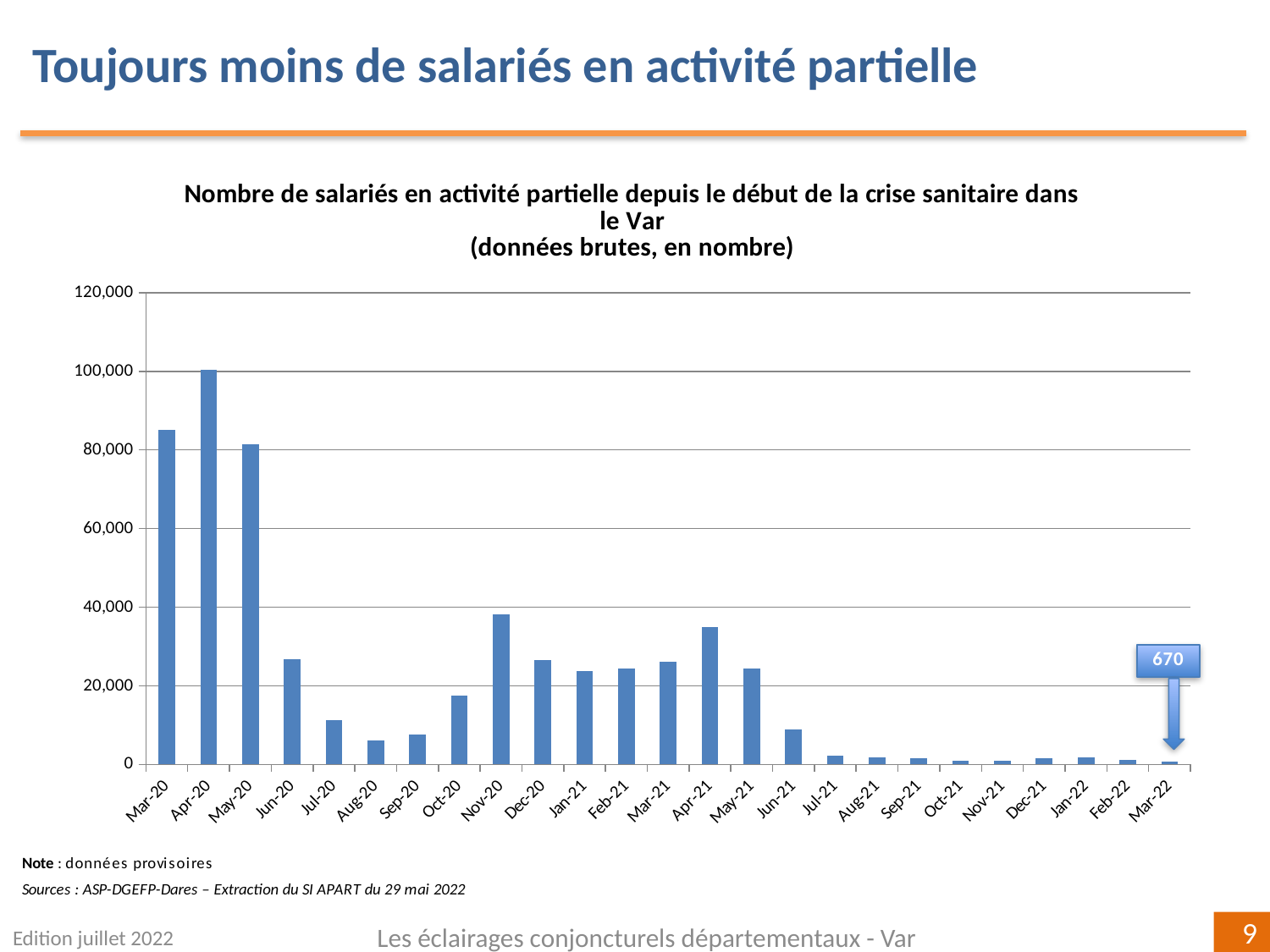
Is the value for Mar-20 greater or less than 80,000? greater Which is larger, the value for Apr-20 or the value for Mar-20? Apr-20 Which is larger, the value for Nov-20 or the value for Oct-20? Nov-20 What is the first month shown on the x axis? Mar-20 What is the value for Mar-22? 670 What kind of chart is shown on the slide? bar chart How many months are plotted on the x axis? 25 Which month has the highest number of salariés en activité partielle? Apr-20 Is the value for Jul-20 greater or less than 20,000? less Overall, do the values rise or fall from Mar-20 to Mar-22? fall Is the value for Apr-21 greater or less than 20,000? greater